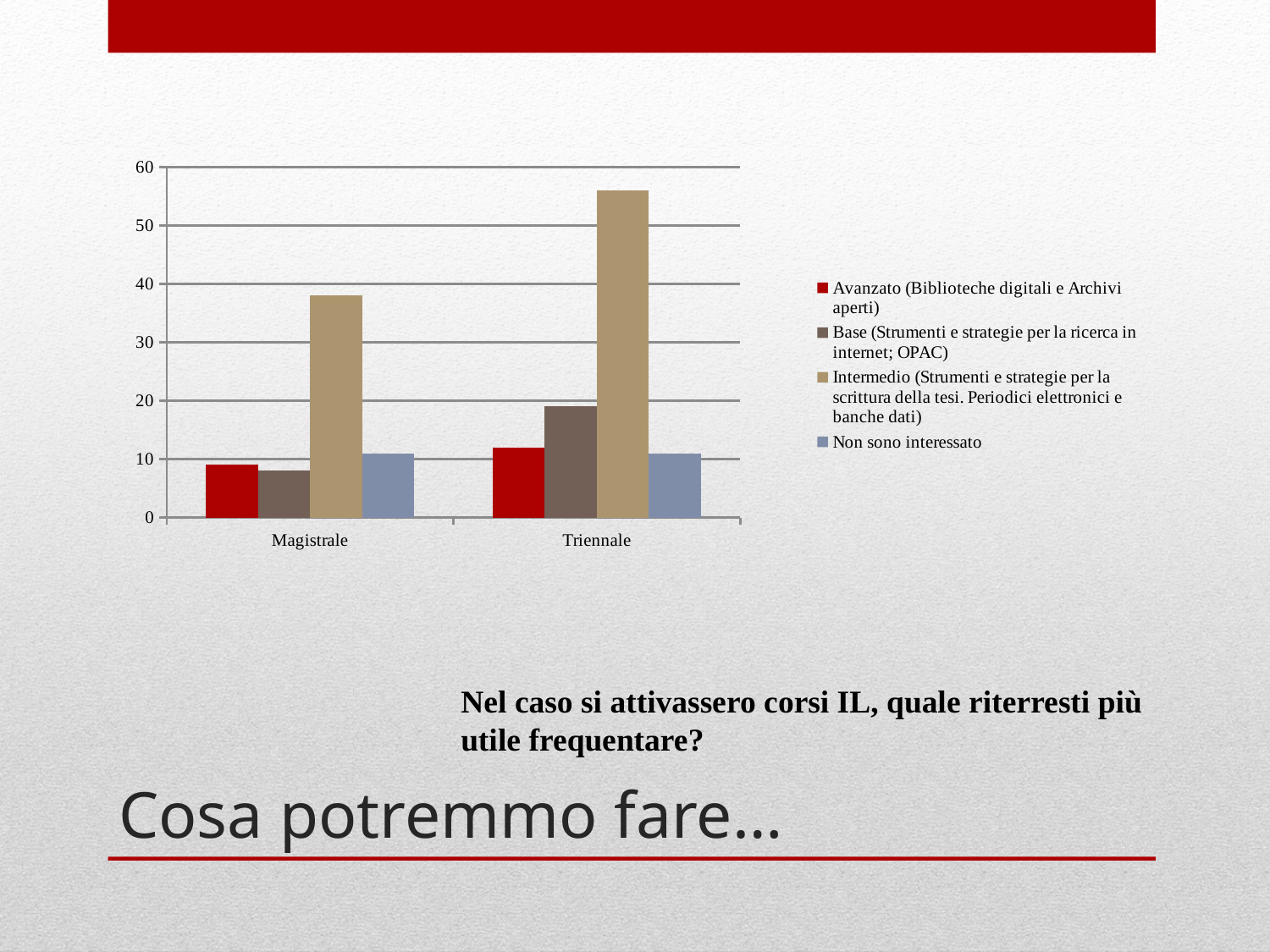
Which series has the highest value for Triennale? Intermedio (Strumenti e strategie per la scrittura della tesi. Periodici elettronici e banche dati) What kind of chart is shown on the slide? bar chart Is the Intermedio value for Triennale greater or less than 50? greater Which is larger, the Intermedio value for Magistrale or for Triennale? Triennale Which is larger, the Base value for Magistrale or for Triennale? Triennale What are the two categories on the x axis of the chart? Magistrale and Triennale Which series has the highest value for Magistrale? Intermedio (Strumenti e strategie per la scrittura della tesi. Periodici elettronici e banche dati) Is the Base value for Magistrale greater or less than 10? less Is the Intermedio value for Magistrale greater or less than 30? greater How many categories are shown on the x axis of the chart? 2 How many series does the chart's legend list? 4